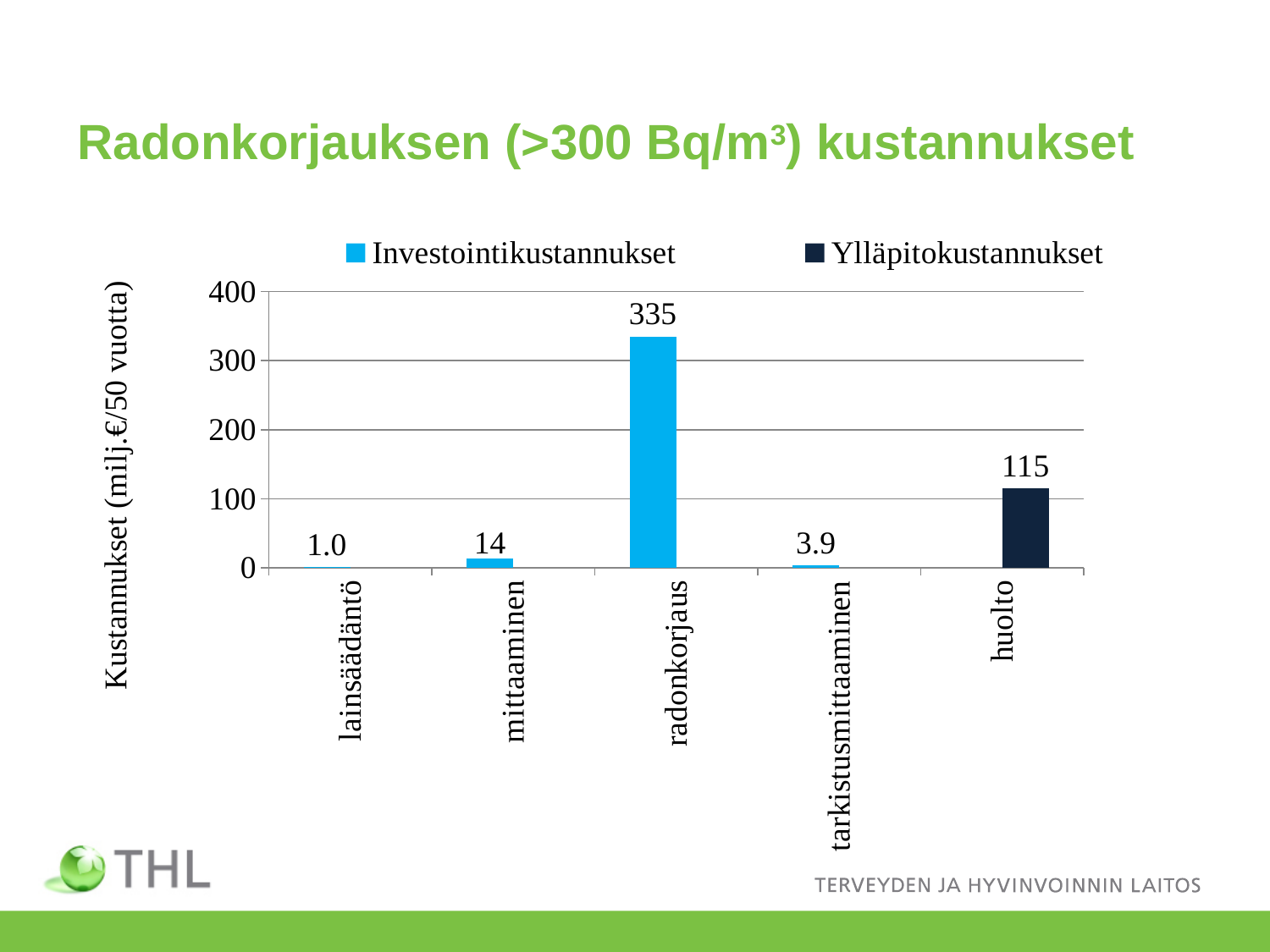
What is the value for huolto? 115 What is the value for tarkistusmittaaminen? 3.9 Which category has the lowest value? lainsäädäntö What is the value for radonkorjaus? 335 Which is larger, the value for mittaaminen or the value for tarkistusmittaaminen? mittaaminen What is the value for lainsäädäntö? 1.0 What is the value for mittaaminen? 14 What is the difference between the values for radonkorjaus and huolto? 220 What kind of chart is shown on the slide? bar chart How many series does the legend list? 2 Which category has the highest value? radonkorjaus How many categories are shown on the x axis? 5